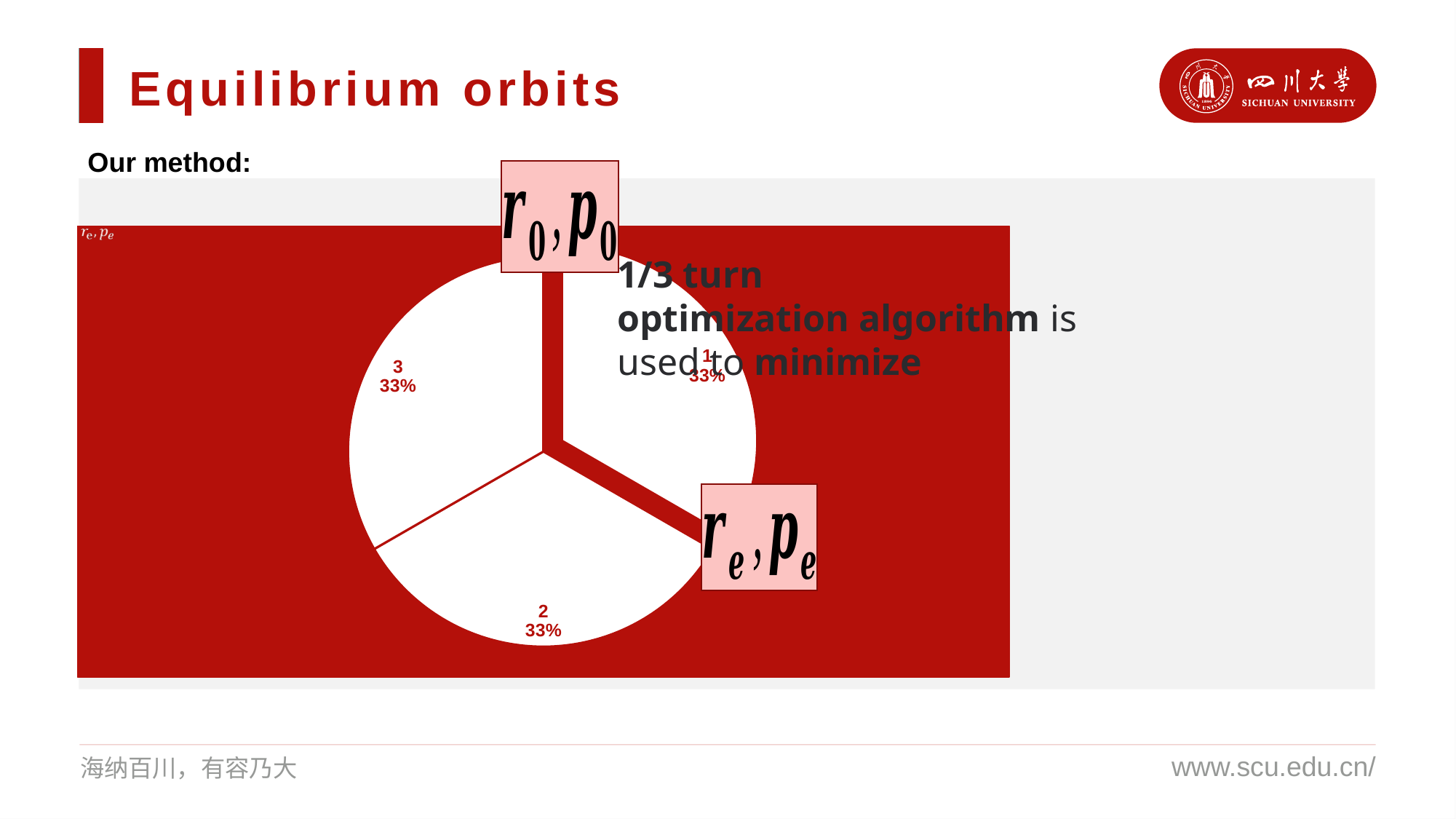
How many slices does the pie chart have? 3 What percentage label is shown on slice 3 of the pie chart? 33% What percentage label is shown on slice 2 of the pie chart? 33% What kind of chart is shown on the slide? pie chart What share of the pie does slice 2 represent? 33% What colour are the slices of the pie chart? white What share of the pie does slice 3 represent? 33% Which slice of the pie chart is labelled at the bottom of the pie? 2